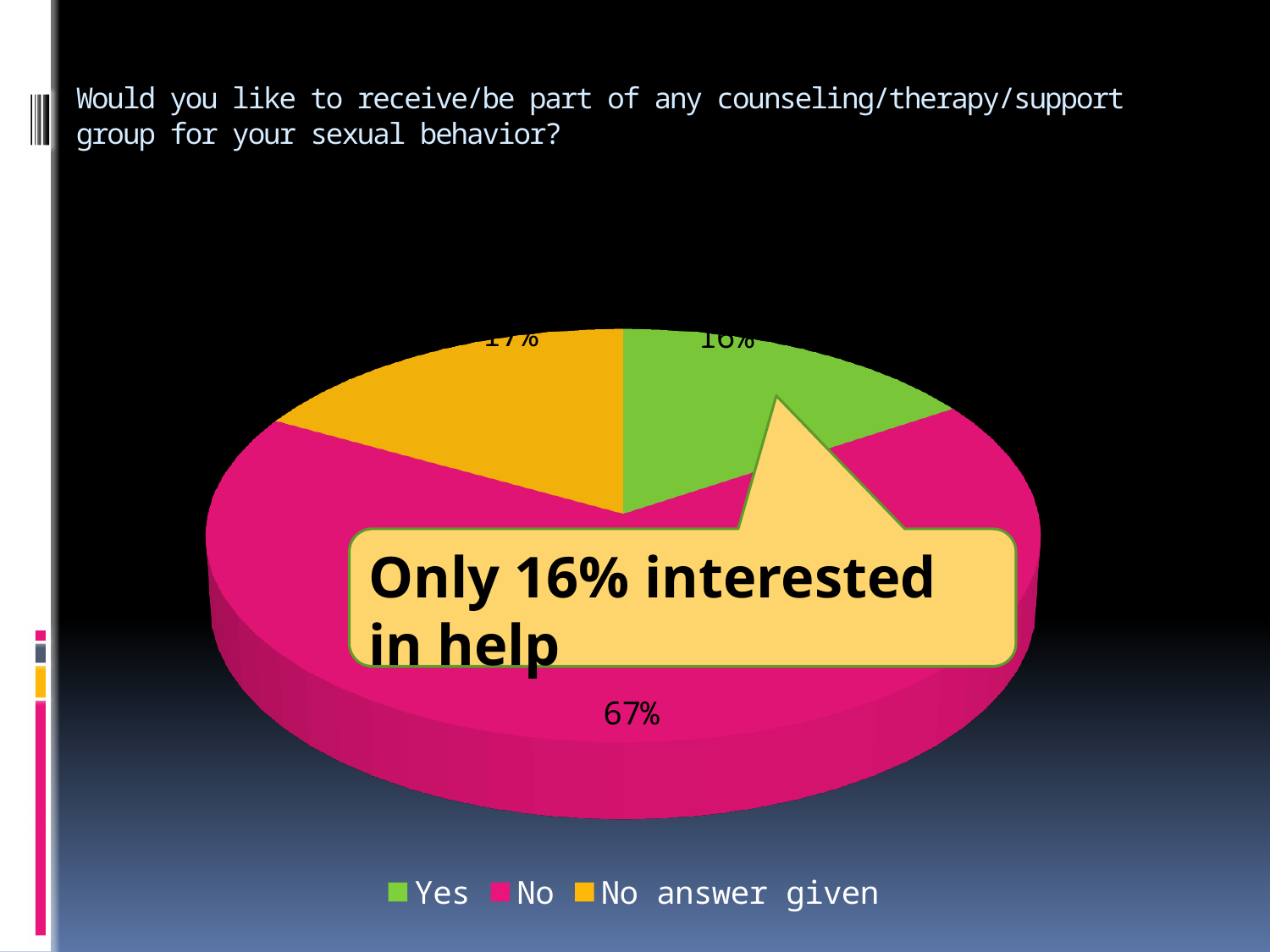
Is the share for "Yes" greater or less than 25%? less What is the difference in percentage points between the "No" share and the "Yes" share? 51% Which is larger, the share for "No" or the share for "Yes"? No How many entries does the legend list? 3 Is the share for "No" greater or less than 50%? greater How many slices does the pie chart have? 3 What kind of chart is shown on the slide? pie chart What does the callout box on the chart say? Only 16% interested in help What percentage of respondents answered "No"? 67% What colour is the "No" slice of the pie? pink What percentage of respondents answered "Yes"? 16% Which response has the largest share of the pie? No